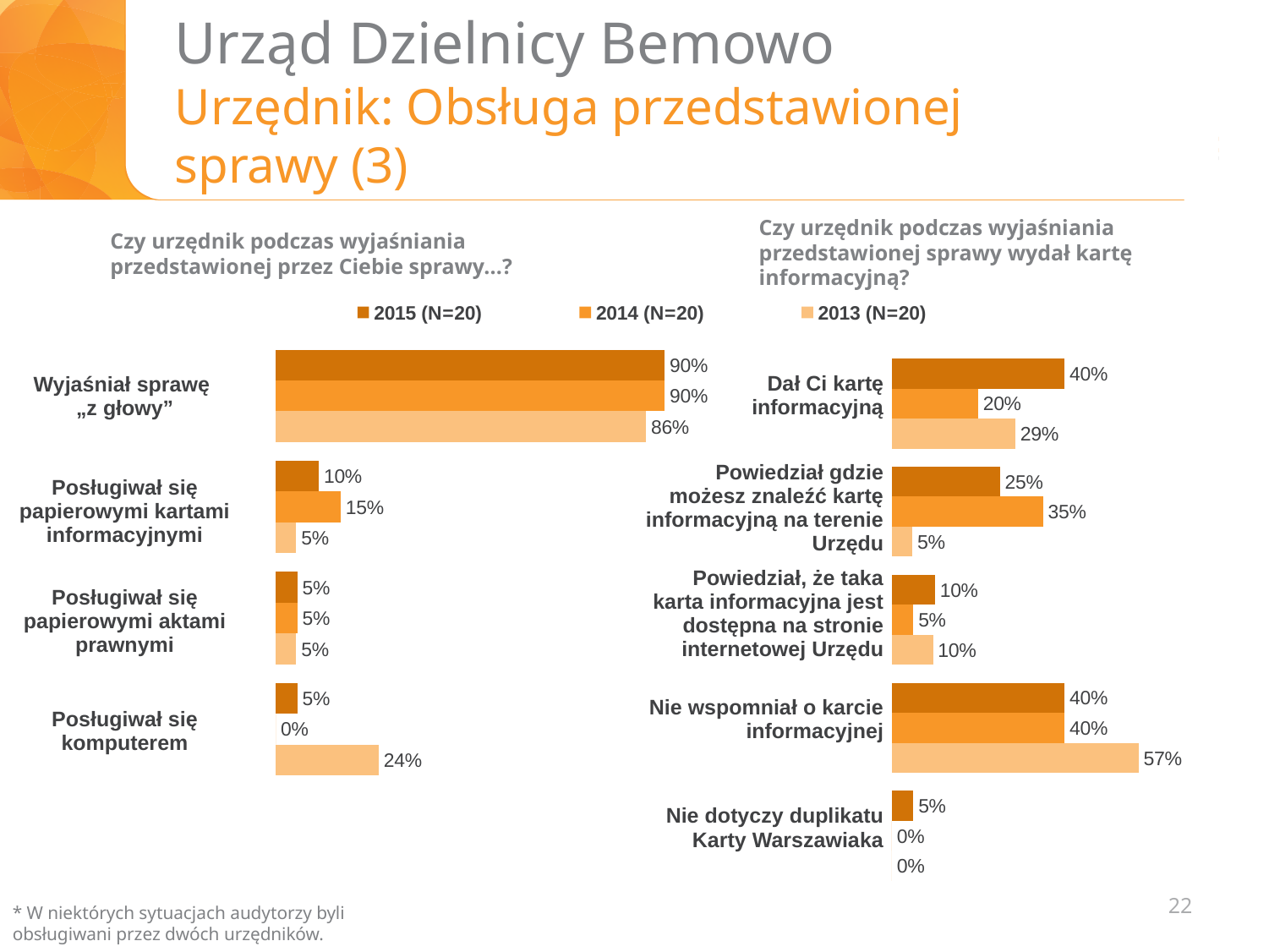
How many series does the legend list? 3 In the right chart, which is larger for "Dał Ci kartę informacyjną": the 2015 value or the 2014 value? 2015 (40%) In the left chart, what is the 2014 (N=20) value for "Posługiwał się papierowymi kartami informacyjnymi"? 15% In the left chart ("Czy urzędnik podczas wyjaśniania przedstawionej przez Ciebie sprawy...?"), what is the 2015 (N=20) value for "Wyjaśniał sprawę „z głowy”"? 90% In the left chart, how many categories are shown? 4 What type of chart is used on this slide? Bar chart In the right chart ("Czy urzędnik podczas wyjaśniania przedstawionej sprawy wydał kartę informacyjną?"), what is the 2013 (N=20) value for "Nie wspomniał o karcie informacyjnej"? 57% In the right chart, what is the 2014 (N=20) value for "Powiedział gdzie możesz znaleźć kartę informacyjną na terenie Urzędu"? 35% In the left chart, what is the 2013 (N=20) value for "Posługiwał się komputerem"? 24% In the right chart, which category has the lowest 2015 (N=20) value? Nie dotyczy duplikatu Karty Warszawiaka In the left chart, what is the difference between the 2015 and 2013 values for "Wyjaśniał sprawę „z głowy”"? 4 percentage points In the left chart, which category has the highest 2013 (N=20) value? Wyjaśniał sprawę „z głowy”